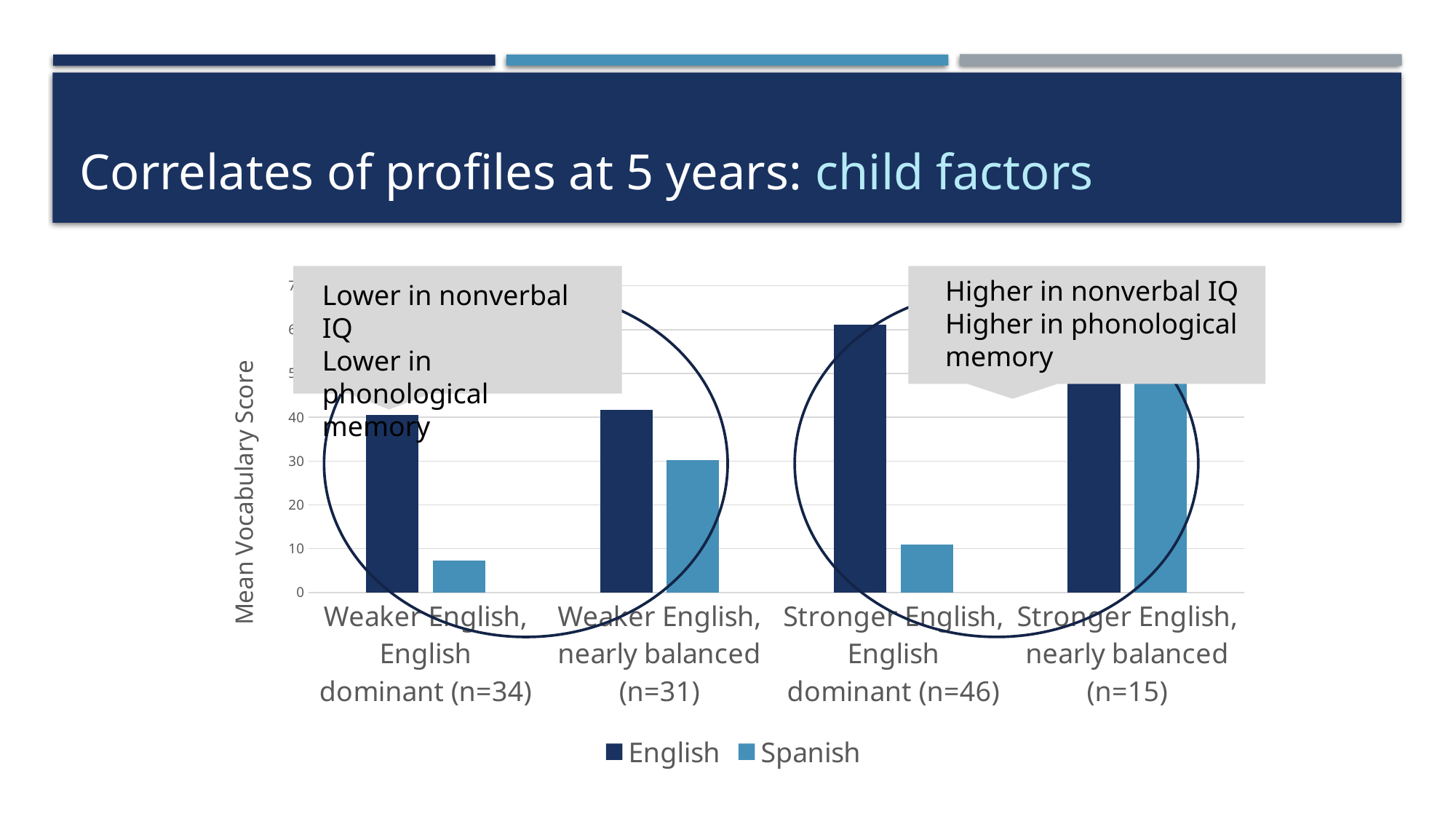
Which group has the lowest Spanish mean vocabulary score? Weaker English, English dominant (n=34) How many series does the legend list? 2 Which is larger: the Spanish score for Weaker English, nearly balanced (n=31) or the Spanish score for Stronger English, English dominant (n=46)? Weaker English, nearly balanced (n=31) For Weaker English, English dominant (n=34), which is larger: the English or the Spanish score? English How many profile groups (categories) are shown on the x axis? 4 What kind of chart is shown on the slide? bar chart Is the English value for Stronger English, English dominant (n=46) greater or less than 50? greater Is the Spanish value for Stronger English, English dominant (n=46) greater or less than 20? less Is the Spanish value for Weaker English, English dominant (n=34) greater or less than 10? less Which two series are listed in the legend? English and Spanish What is the label of the vertical axis? Mean Vocabulary Score